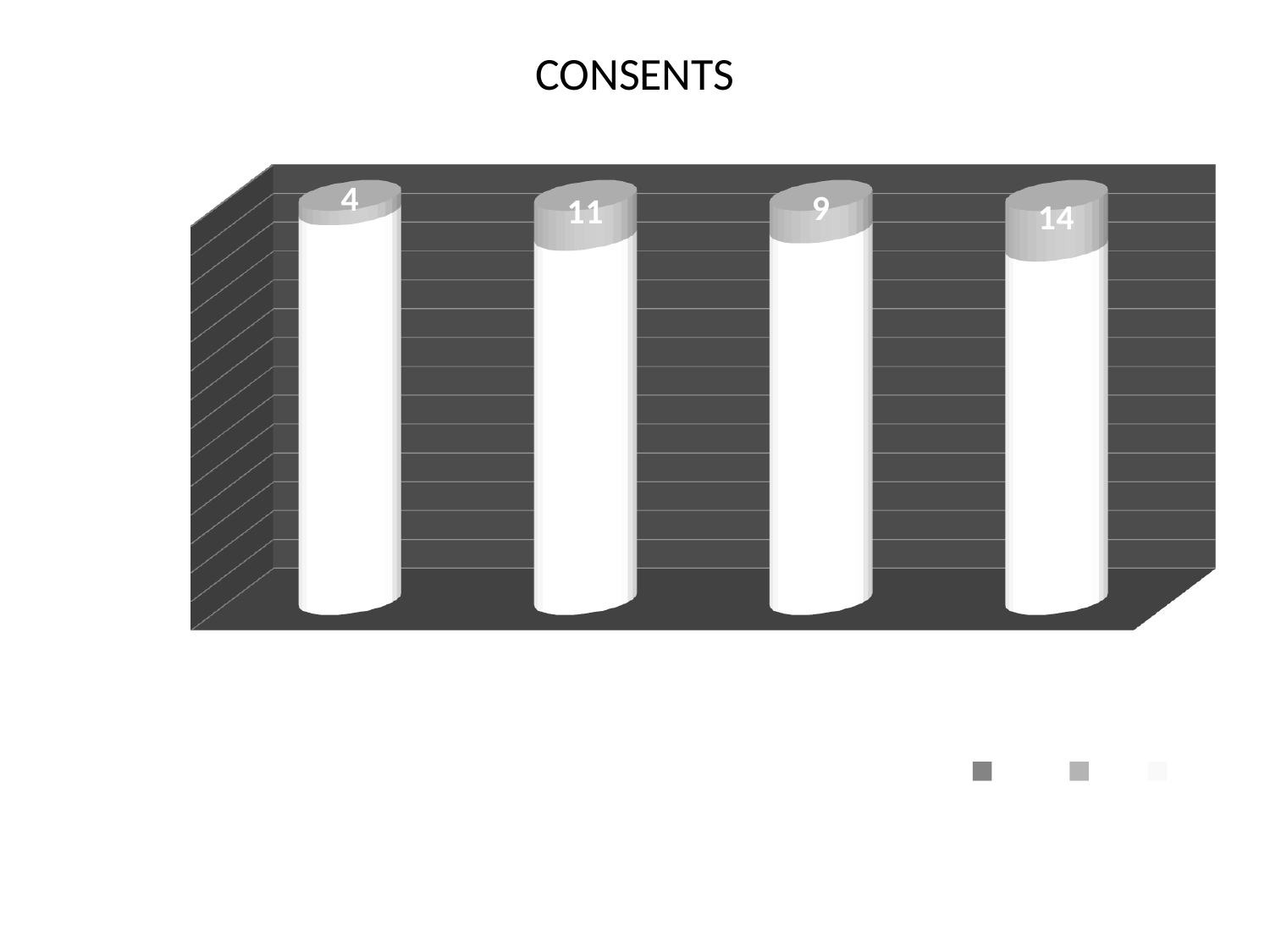
What value is labelled on the first bar from the left? 4 What is the title of the chart? CONSENTS How many entries does the legend show? 3 What kind of chart is shown on the slide? bar chart How many bars are plotted in the chart? 4 What value is labelled on the second bar from the left? 11 Which bar has the lowest labelled value? the first bar from the left (4) What is the difference between the labelled values of the fourth and first bars? 10 Which has the larger labelled value, the second bar or the third bar? the second bar (11) What value is labelled on the fourth bar from the left? 14 What value is labelled on the third bar from the left? 9 Which bar has the highest labelled value? the fourth bar from the left (14)